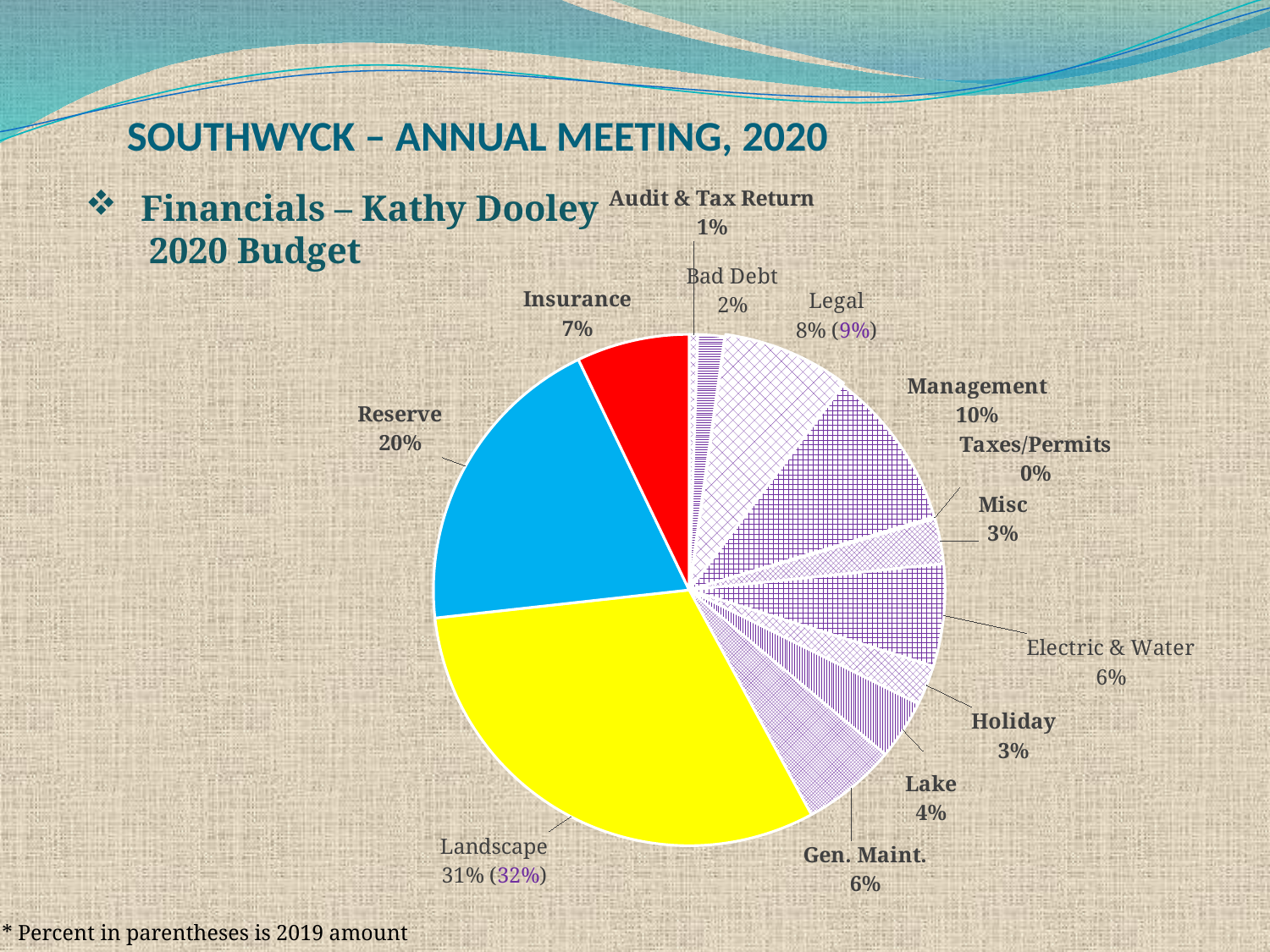
Which has a larger share of the 2020 budget, Insurance or Electric & Water? Insurance How many categories are shown in the pie chart? 13 What colour is the Landscape slice? yellow Which category has the largest share of the 2020 budget? Landscape What share of the 2020 budget is Management? 10% What kind of chart is shown on the slide? pie chart What is the difference in percentage points between Landscape and Reserve? 11 What share of the 2020 budget is Landscape? 31% What was the 2019 percentage for Legal, shown in parentheses? 9% Which category has the smallest share of the 2020 budget? Taxes/Permits What colour is the Insurance slice? red What share of the 2020 budget is Reserve? 20%